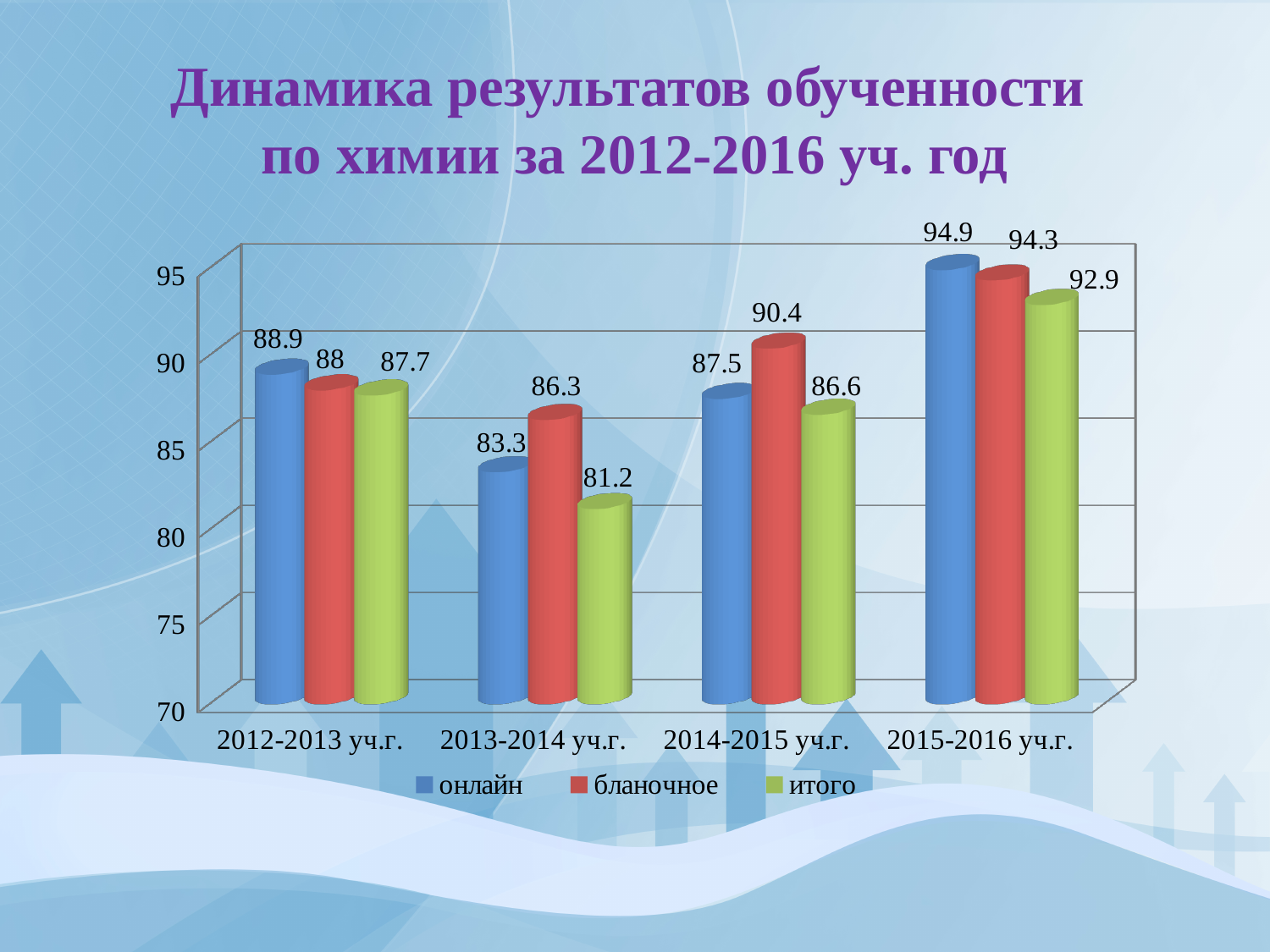
Which colour represents the итого series in the legend? green What is the value for онлайн in 2015-2016 уч.г.? 94.9 What is the value for бланочное in 2012-2013 уч.г.? 88 What is the value for бланочное in 2013-2014 уч.г.? 86.3 What is the difference between the бланочное and онлайн values in 2014-2015 уч.г.? 2.9 What is the value for итого in 2014-2015 уч.г.? 86.6 How many series does the legend list? 3 What kind of chart is shown on the slide? bar chart In which year is the онлайн value highest? 2015-2016 уч.г. In which year is the итого value lowest? 2013-2014 уч.г. How many years (categories) are shown on the x axis? 4 Which is larger in 2013-2014 уч.г.: онлайн or бланочное? бланочное